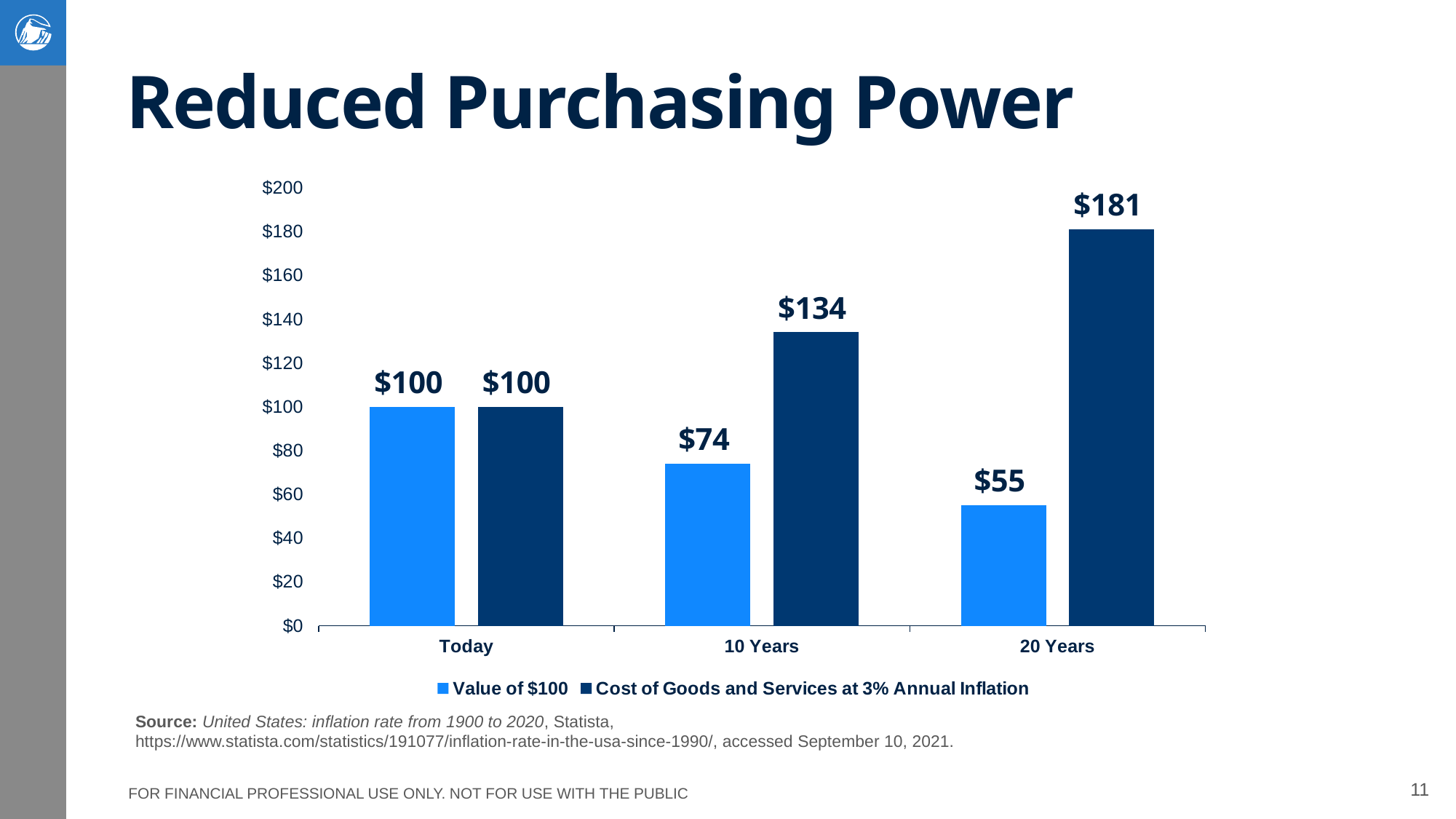
Which category has the highest Cost of Goods and Services at 3% Annual Inflation? 20 Years Which is larger at 10 Years: the Value of $100 or the Cost of Goods and Services at 3% Annual Inflation? Cost of Goods and Services at 3% Annual Inflation How many series does the legend list? 2 What is the Value of $100 after 20 Years? $55 What is the Cost of Goods and Services at 3% Annual Inflation after 20 Years? $181 Which category has the lowest Value of $100? 20 Years What is the Cost of Goods and Services at 3% Annual Inflation after 10 Years? $134 Does the Value of $100 rise or fall from Today to 20 Years? Fall What kind of chart is shown on the slide? Bar chart What is the Value of $100 after 10 Years? $74 What is the difference between the Cost of Goods and Services at 3% Annual Inflation and the Value of $100 at 20 Years? $126 How many categories are shown on the x axis? 3